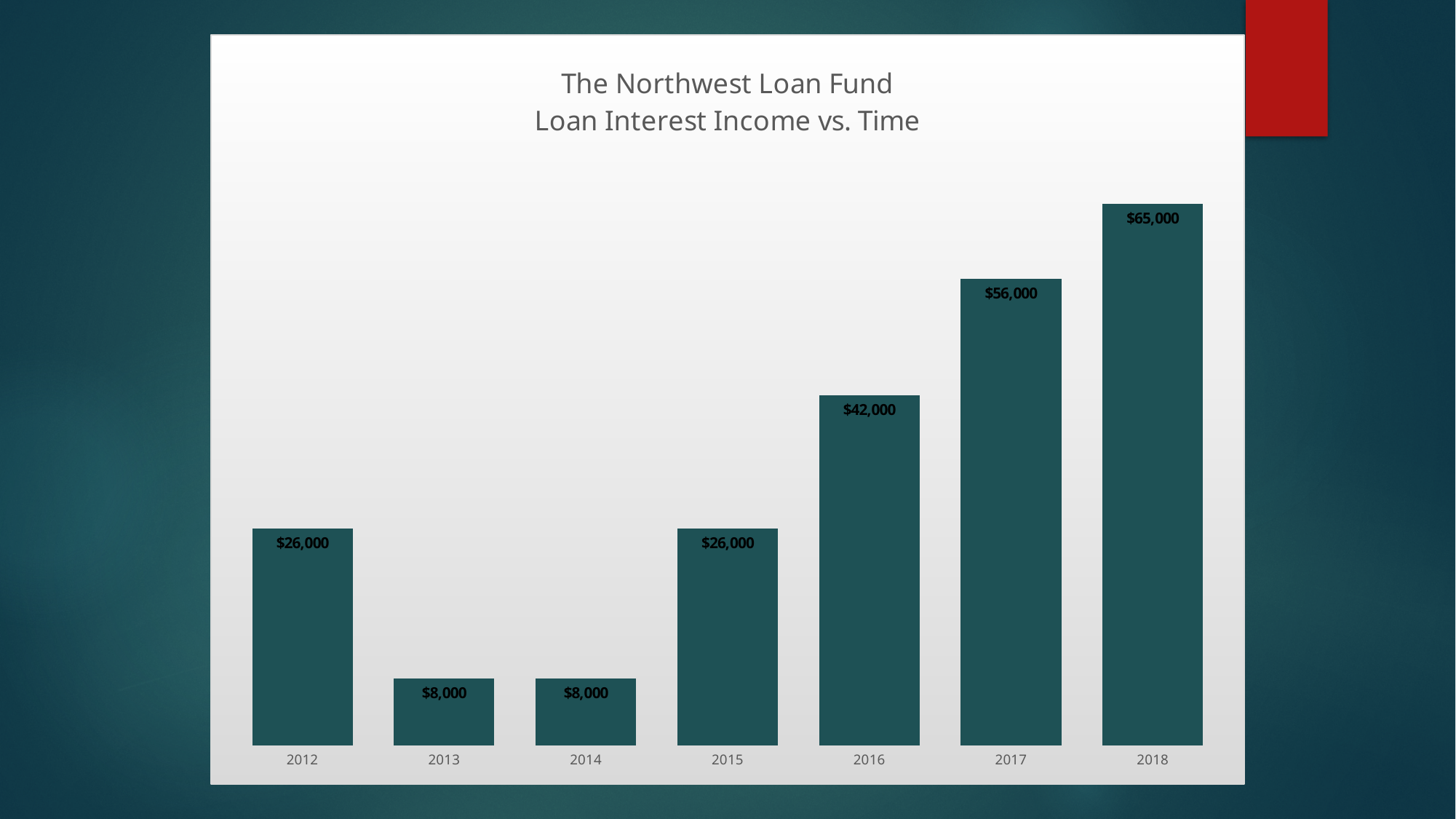
What is the difference in loan interest income between 2018 and 2017? $9,000 Do the loan interest income values rise or fall from 2014 to 2018? Rise Which two years have the same loan interest income of $26,000? 2012 and 2015 Which year has the highest loan interest income? 2018 What is the loan interest income for 2016? $42,000 What kind of chart is shown on the slide? Bar chart What is the loan interest income for 2018? $65,000 Which year has the larger loan interest income, 2012 or 2016? 2016 What is the title of the chart? The Northwest Loan Fund Loan Interest Income vs. Time What is the loan interest income for 2013? $8,000 What is the difference in loan interest income between 2015 and 2014? $18,000 How many years are shown on the chart? 7